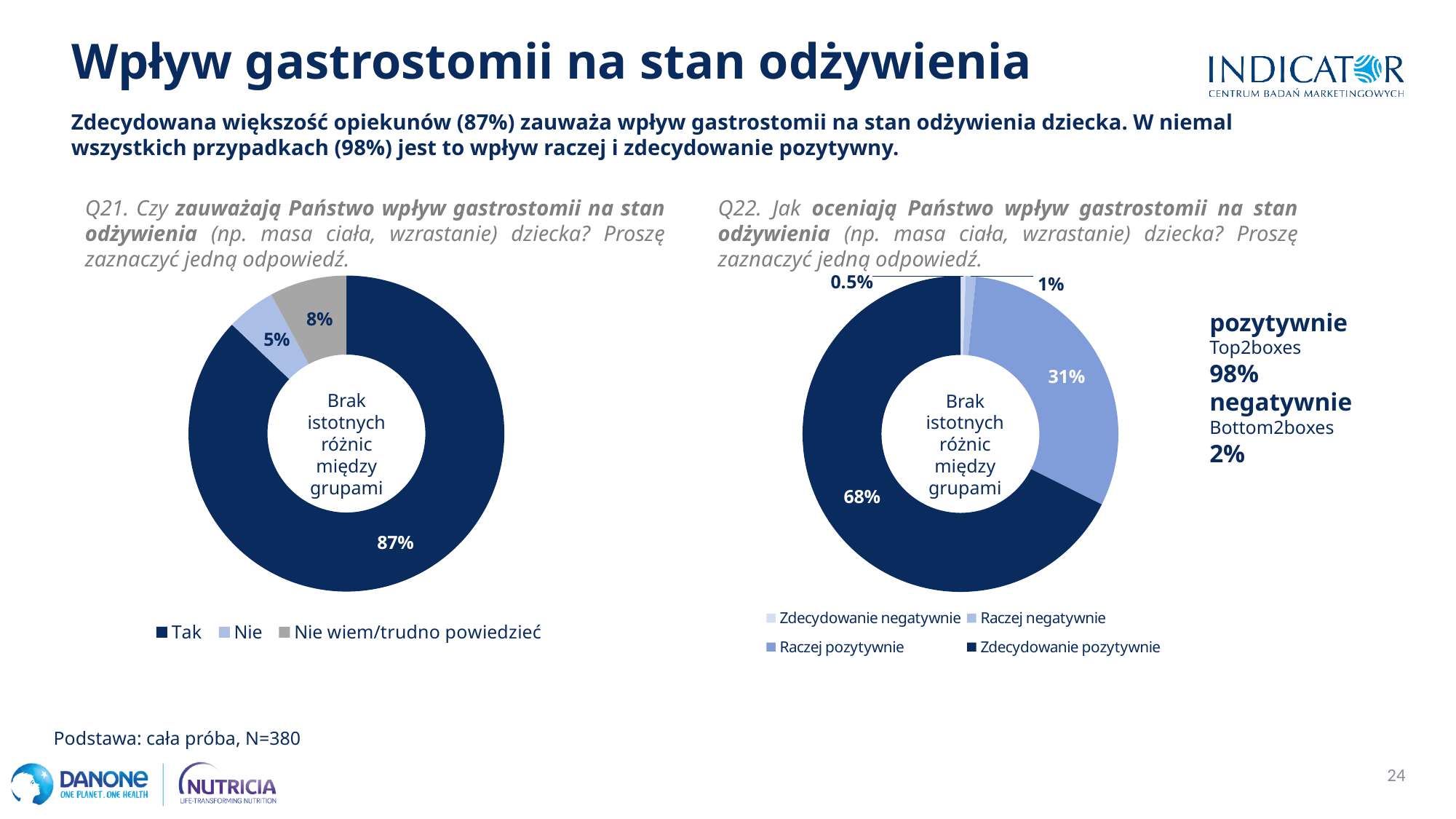
In the right chart (Q22), what is the combined share of "Raczej pozytywnie" and "Zdecydowanie pozytywnie"? 98% In the left chart (Q21), what percentage of respondents answered "Tak"? 87% In the right chart (Q22), which answer has the largest share? Zdecydowanie pozytywnie In the right chart (Q22), which is larger: "Raczej negatywnie" or "Zdecydowanie negatywnie"? Raczej negatywnie In the right chart (Q22), what percentage answered "Zdecydowanie negatywnie"? 0.5% In the left chart (Q21), which answer has the smallest share? Nie What text is shown in the centre of both donut charts? Brak istotnych różnic między grupami How many categories does the legend of the left chart (Q21) list? 3 In the left chart (Q21), what percentage answered "Nie wiem/trudno powiedzieć"? 8% In the right chart (Q22), what percentage answered "Raczej pozytywnie"? 31% What type of chart is used for Q21 and Q22 on this slide? Donut (pie) chart In the left chart (Q21), what is the difference in percentage points between "Tak" and "Nie"? 82